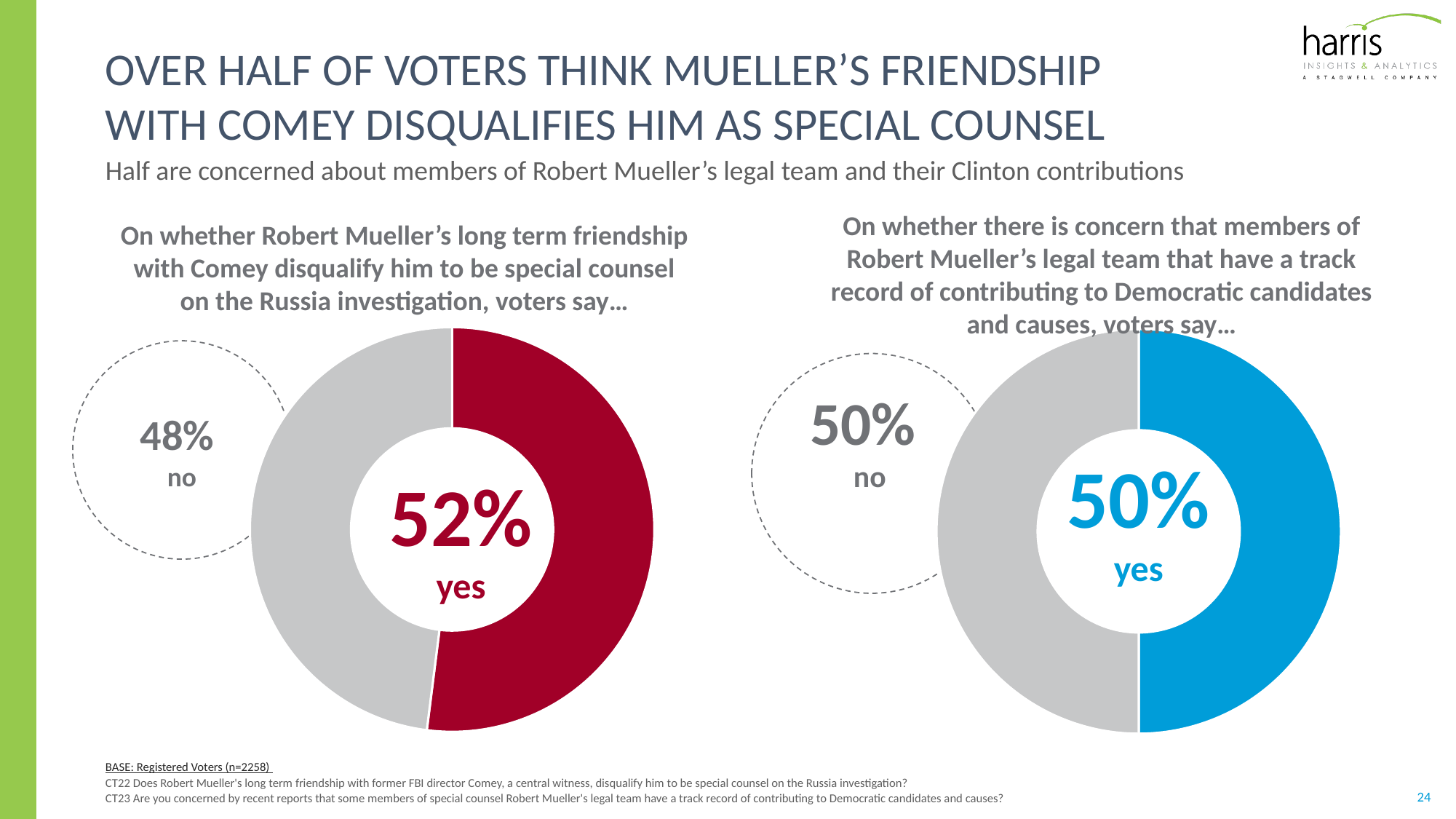
What colour is the 'yes' segment in the left chart (Mueller's friendship with Comey)? Red In the left chart (Mueller's friendship with Comey), which response has the larger share, yes or no? yes In the right chart (concern about Mueller's legal team contributions), what percentage of voters say yes? 50% In the left chart (Mueller's friendship with Comey), what is the difference in percentage points between yes and no? 4 What colour is the 'yes' segment in the right chart (concern about Mueller's legal team contributions)? Blue How many response categories does the right chart (concern about Mueller's legal team contributions) show? 2 What type of chart is used on the left side of the slide? Donut (pie) chart Is the 'yes' share in the left chart (Mueller's friendship with Comey) greater or less than 50%? greater In the right chart (concern about Mueller's legal team contributions), what percentage of voters say no? 50% In the left chart (Mueller's friendship with Comey), what percentage of voters say no? 48% In the left chart (Mueller's friendship with Comey), what is the total of the yes and no shares? 100% In the left chart (Mueller's friendship with Comey), what percentage of voters say yes? 52%